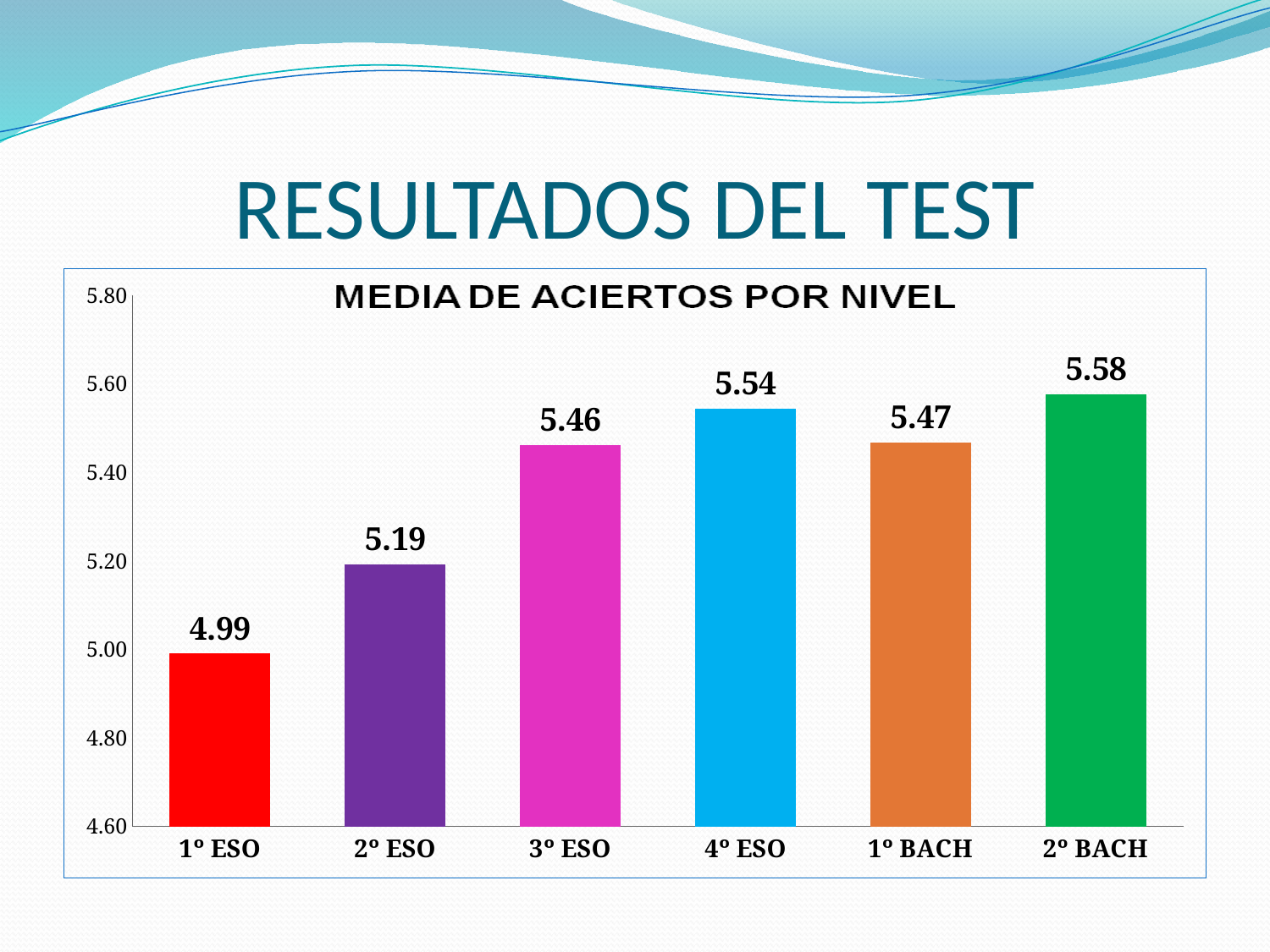
Which is larger, the value for 2º ESO or the value for 3º ESO? 3º ESO Which level has the highest value? 2º BACH What is the value for 1º BACH? 5.47 Is the value for 2º ESO greater or less than 5.00? greater Which level has the lowest value? 1º ESO What is the value for 1º ESO? 4.99 What is the value for 3º ESO? 5.46 What is the difference between the values for 2º BACH and 1º ESO? 0.59 What is the title of the chart? MEDIA DE ACIERTOS POR NIVEL What kind of chart is shown? bar chart How many levels are shown on the x axis? 6 What is the difference between the values for 4º ESO and 2º ESO? 0.35